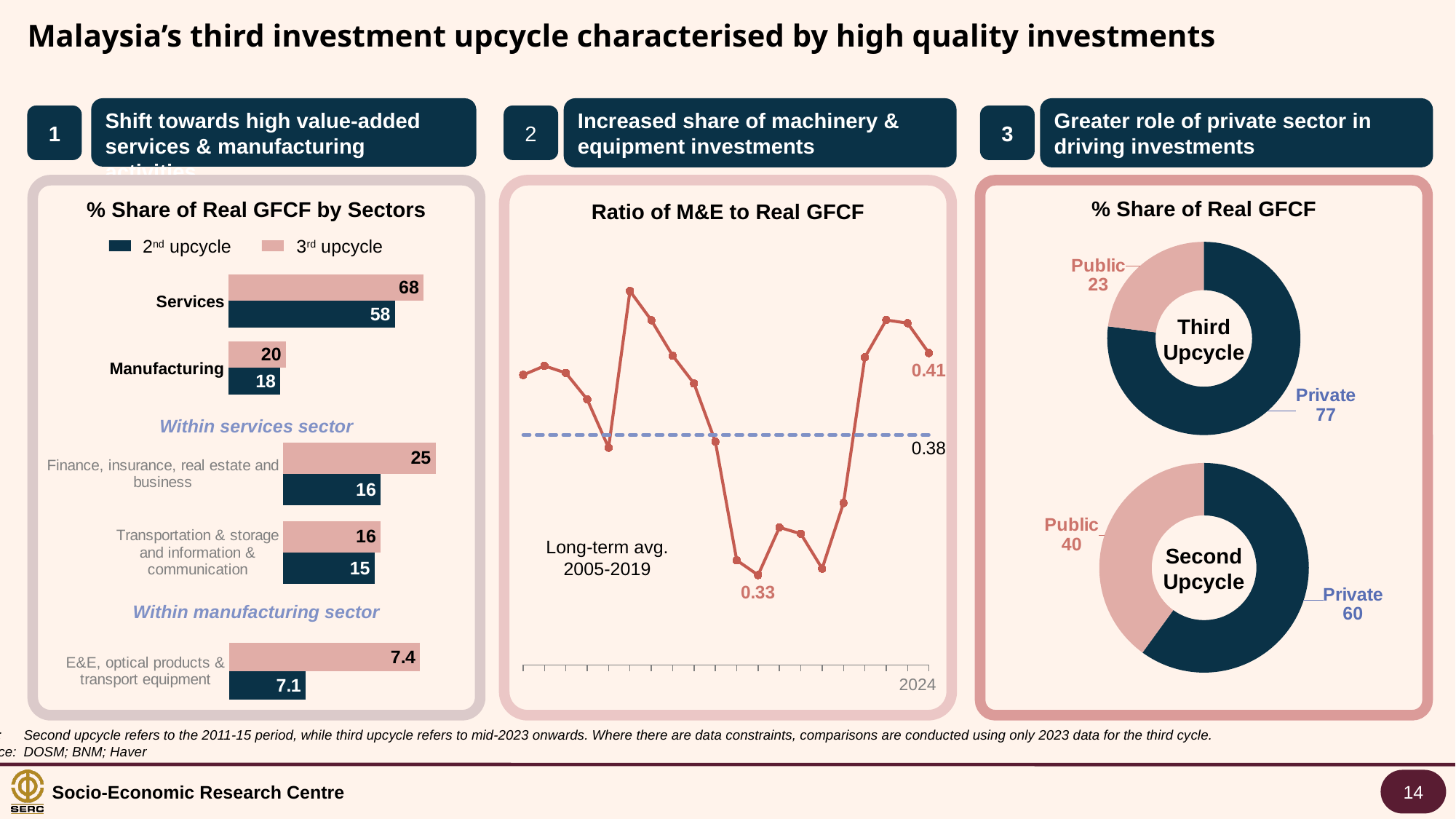
In the '% Share of Real GFCF by Sectors' chart, which category has the highest 2nd upcycle value? Services In the '% Share of Real GFCF by Sectors' chart, what is the 2nd upcycle value for Manufacturing? 18 What kind of chart is 'Ratio of M&E to Real GFCF'? Line chart In the 'Ratio of M&E to Real GFCF' chart, what is the lowest labelled value on the line? 0.33 In the '% Share of Real GFCF' donut charts, what is the Public share in the Second Upcycle? 40 In the 'Ratio of M&E to Real GFCF' chart, what is the labelled value at the end of the line in 2024? 0.41 In the '% Share of Real GFCF by Sectors' chart, what is the 3rd upcycle value for Services? 68 In the '% Share of Real GFCF by Sectors' chart, what is the difference between the 3rd upcycle and 2nd upcycle values for Finance, insurance, real estate and business? 9 In the '% Share of Real GFCF' donut charts, what is the Private share in the Third Upcycle? 77 In the 'Ratio of M&E to Real GFCF' chart, what is the long-term average for 2005-2019? 0.38 In the '% Share of Real GFCF by Sectors' chart, what is the 3rd upcycle value for E&E, optical products & transport equipment? 7.4 In the '% Share of Real GFCF by Sectors' chart, how many series does the legend list? 2